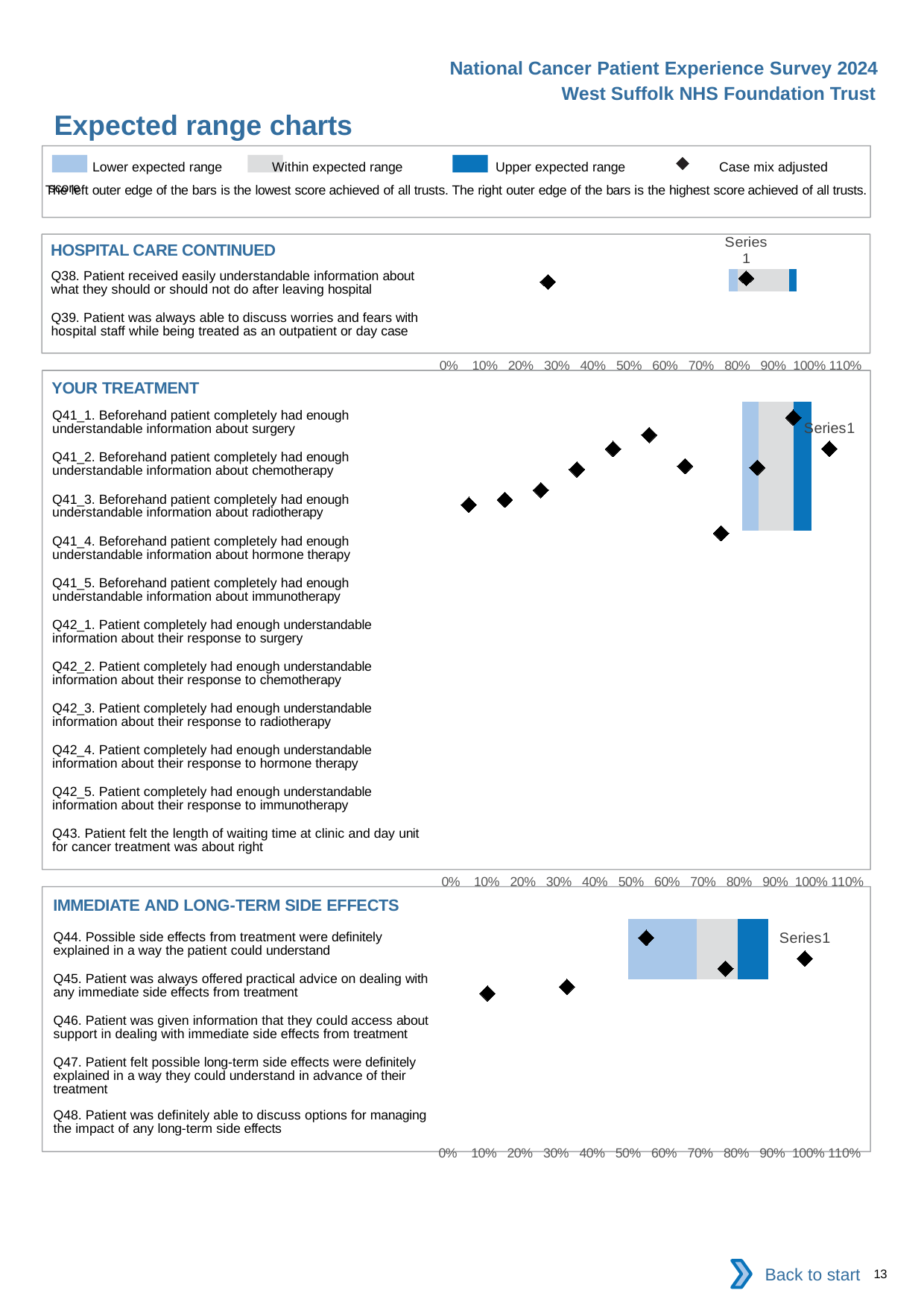
In the legend at the top of the slide, which colour represents the upper expected range? Dark blue What is the highest tick label on the horizontal axis of the YOUR TREATMENT chart? 110% How many questions are listed in the IMMEDIATE AND LONG-TERM SIDE EFFECTS chart? 5 How many diamond markers are plotted in the YOUR TREATMENT chart? 11 How many questions are listed in the HOSPITAL CARE CONTINUED chart? 2 In the legend at the top of the slide, which marker represents the case mix adjusted score? A black diamond How many legend entries are shown at the top of the slide for the expected range charts? 4 What kind of chart is used for the expected range charts on this slide? Bar chart